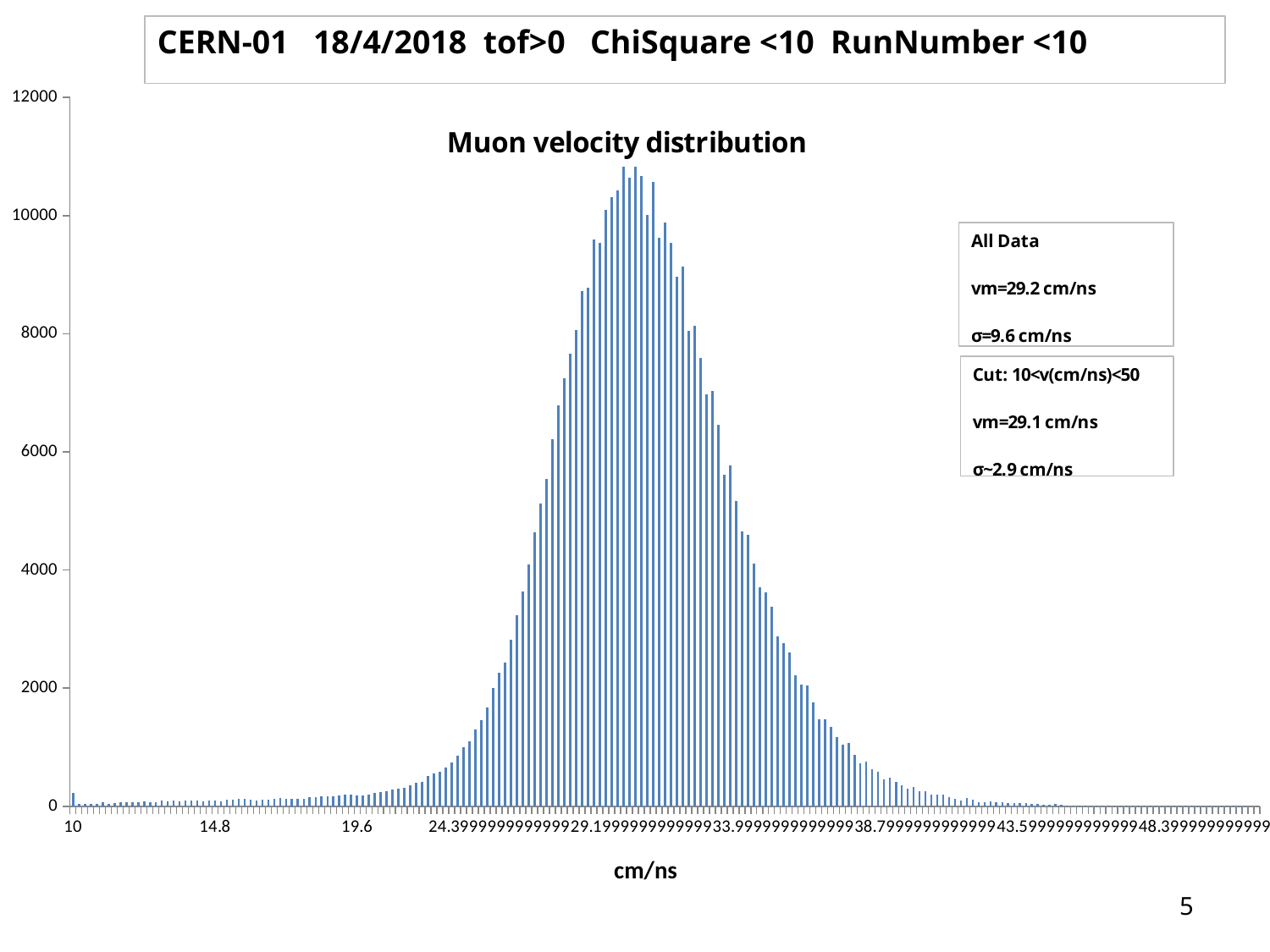
According to the 'Cut: 10<v(cm/ns)<50' box on the chart, what is σ? ~2.9 cm/ns Do the bar values rise or fall as the x axis goes from about 34 cm/ns to 48.4 cm/ns? fall Is the value of the tallest bar in the chart greater or less than 10000? greater Do the bar values rise or fall as the x axis goes from 10 cm/ns to about 29 cm/ns? rise Is the value of the bar at 19.6 cm/ns greater or less than 2000? less Is the value of the bar at about 34 cm/ns greater or less than 4000? less What is the highest value shown on the y axis of the chart? 12000 What is the title of the chart? Muon velocity distribution According to the 'All Data' box on the chart, what is vm? 29.2 cm/ns What is the label on the x axis of the chart? cm/ns What kind of chart is shown on the slide? bar chart